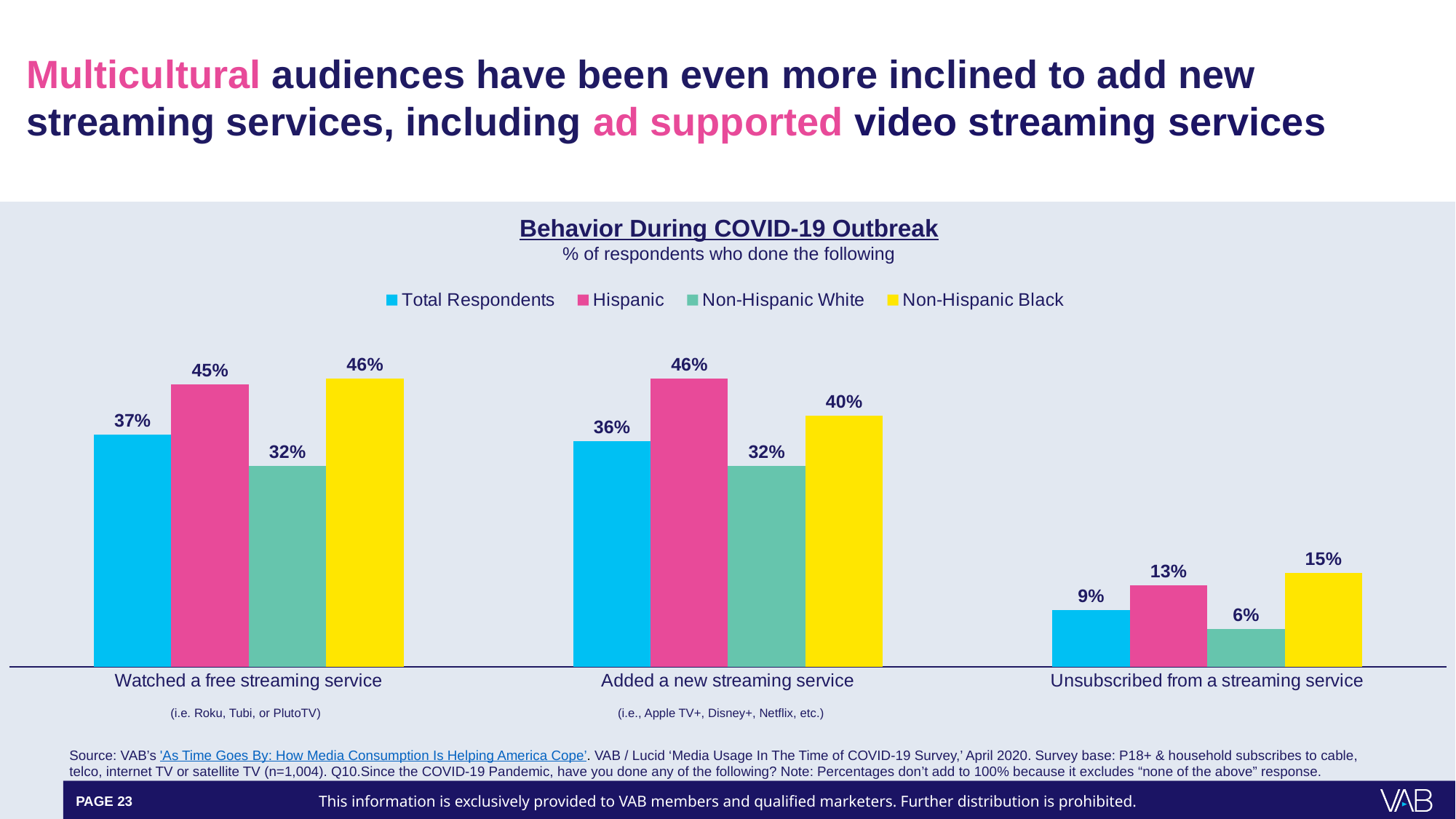
How many behavior categories are shown on the x axis? 3 Which group has the highest value for 'Added a new streaming service'? Hispanic What is the title of the chart? Behavior During COVID-19 Outbreak What is the difference between the Non-Hispanic Black and Non-Hispanic White values for 'Watched a free streaming service'? 14% Which colour represents Non-Hispanic Black in the chart? Yellow What percentage of Non-Hispanic Black respondents added a new streaming service? 40% For 'Unsubscribed from a streaming service', which is larger: the Hispanic value or the Non-Hispanic Black value? Non-Hispanic Black How many series does the legend list? 4 Which group has the lowest value for 'Unsubscribed from a streaming service'? Non-Hispanic White What percentage of Hispanic respondents watched a free streaming service? 45% What kind of chart is shown on the slide? Bar chart What percentage of Total Respondents unsubscribed from a streaming service? 9%